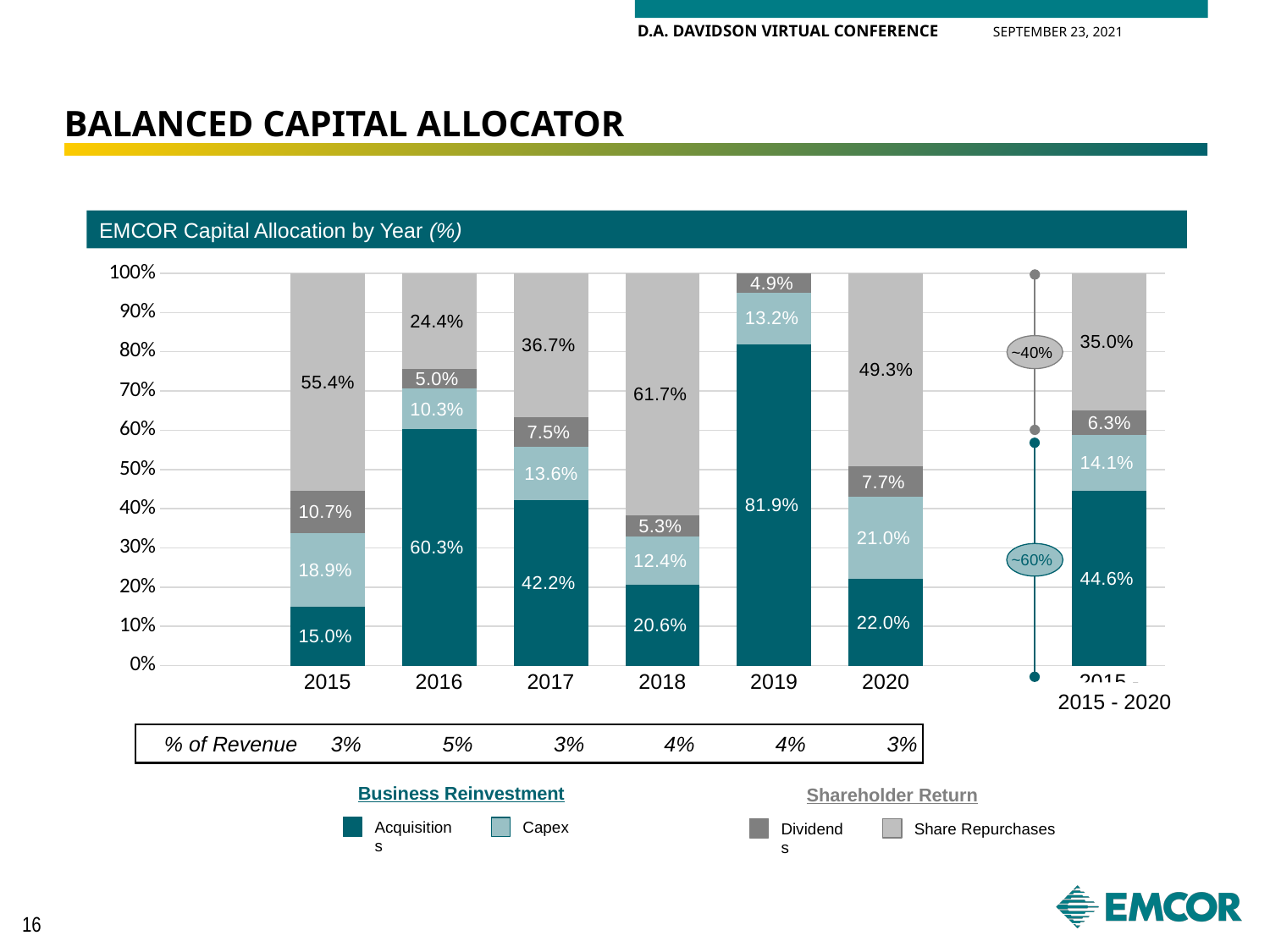
What is the difference between the Share Repurchases values for 2018 and 2016? 37.3% What kind of chart is shown on the slide? Stacked bar chart Which is larger, the Capex value for 2015 or the Capex value for 2017? 2015 What is the Dividends value for the 2015 - 2020 bar? 6.3% Which year has the lowest Acquisitions share? 2015 What is the title of the chart? EMCOR Capital Allocation by Year (%) Which year has the highest Acquisitions share? 2019 What is the Share Repurchases value for 2018? 61.7% How many individual years are shown on the x axis, excluding the 2015 - 2020 aggregate bar? 6 What is the Acquisitions value for 2019? 81.9% How many series does the legend list? 4 What is the Capex value for 2020? 21.0%